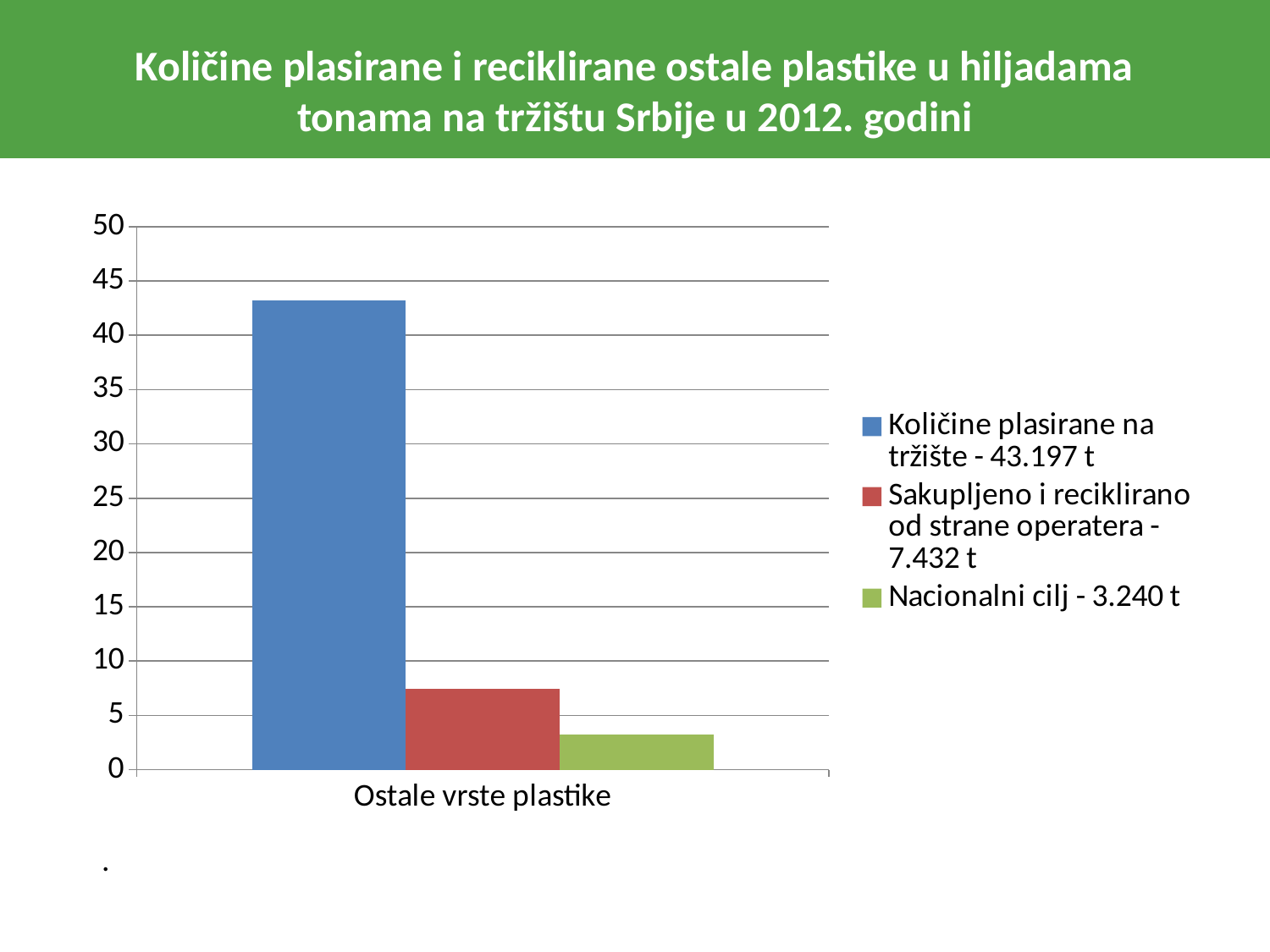
Which series has the highest bar? Količine plasirane na tržište - 43.197 t According to the legend, what is the value for 'Sakupljeno i reciklirano od strane operatera'? 7.432 t Is the bar for 'Sakupljeno i reciklirano od strane operatera' greater or less than 10 on the axis? less According to the legend, what is the value for 'Nacionalni cilj'? 3.240 t What kind of chart is shown on the slide? bar chart How many series does the legend list? 3 Is the bar for 'Količine plasirane na tržište' greater or less than 40 on the axis? greater How many categories are shown on the x axis? 1 Which is larger: 'Sakupljeno i reciklirano od strane operatera' or 'Nacionalni cilj'? Sakupljeno i reciklirano od strane operatera Which series has the lowest bar? Nacionalni cilj - 3.240 t What is the category label on the x axis? Ostale vrste plastike According to the legend, what is the value for 'Količine plasirane na tržište'? 43.197 t